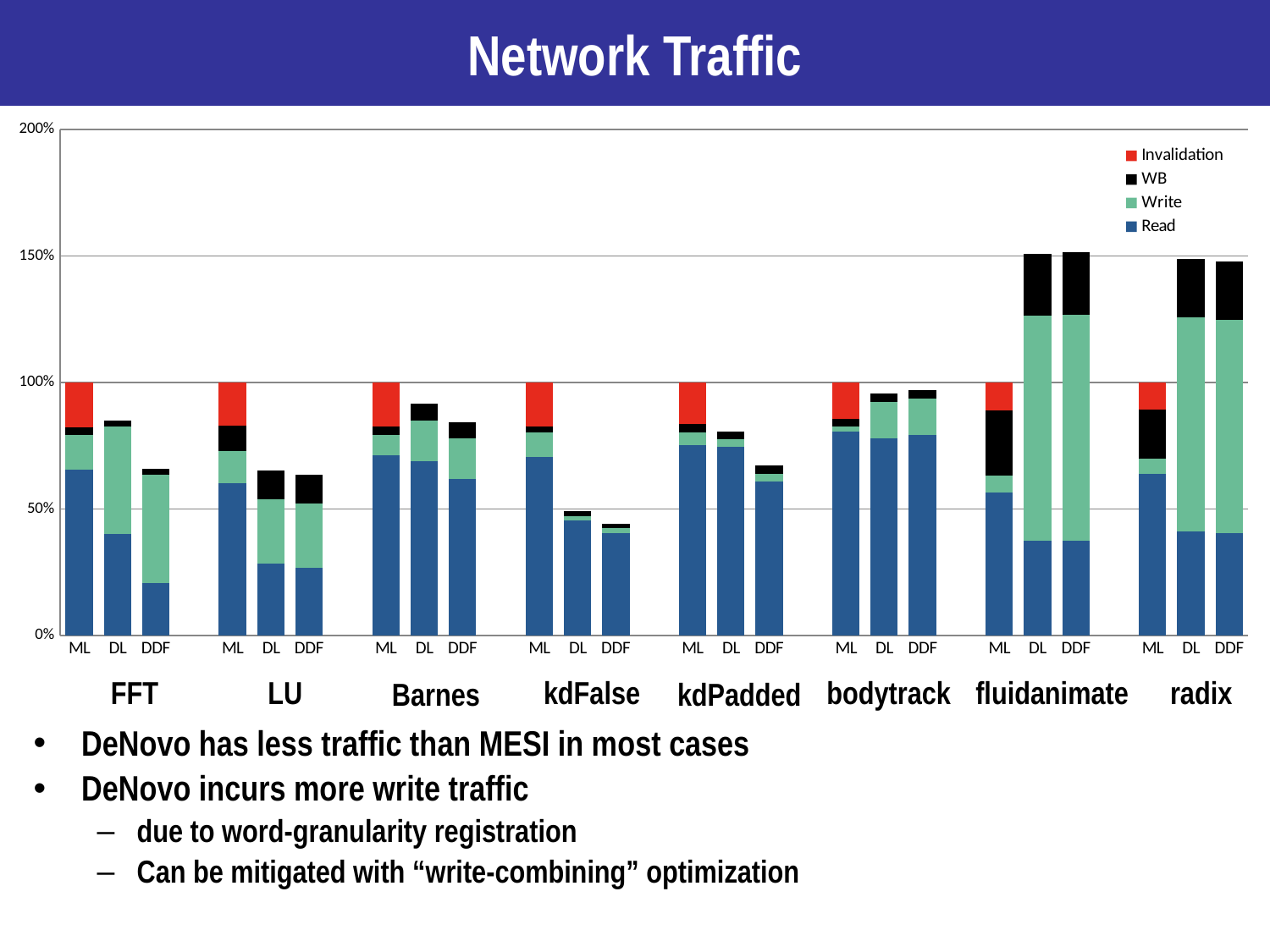
Which is larger, the DL bar for fluidanimate or the DL bar for FFT? fluidanimate DL How many benchmark groups are shown along the x axis? 8 What kind of chart is shown on the slide? stacked bar chart How many series does the legend list? 4 Which benchmark has the lowest DDF bar? kdFalse Is the total for the DL bar in fluidanimate greater or less than 100%? greater What is the total height of the ML bar for radix? 100% How many bars are plotted in total across all benchmark groups? 24 Is the total for the DDF bar in kdFalse greater or less than 50%? less What is the total height of the ML bar for FFT? 100% Is the total for the DDF bar in LU greater or less than 100%? less Which series is shown in red in the legend? Invalidation